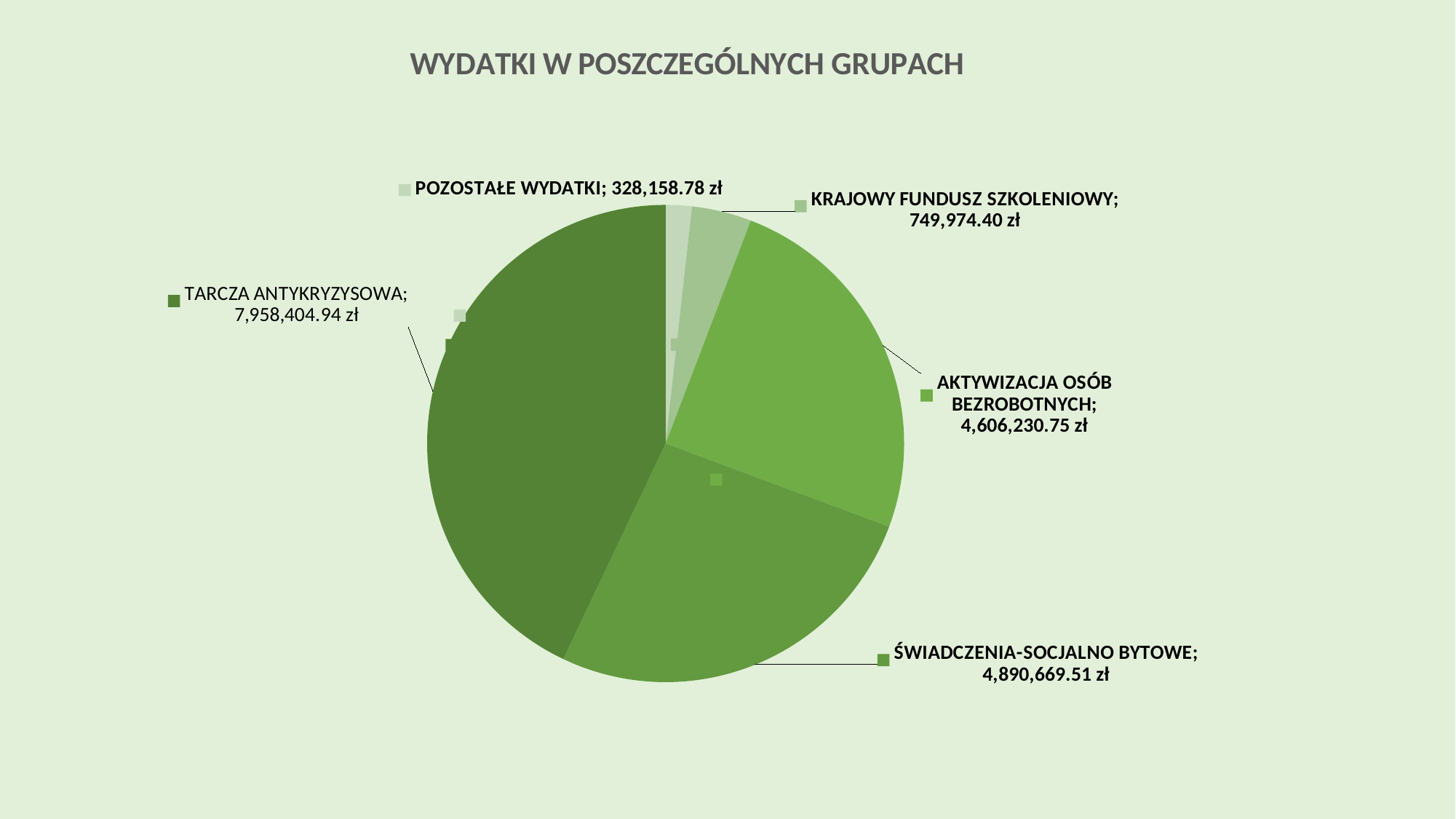
What is the title of the chart? WYDATKI W POSZCZEGÓLNYCH GRUPACH What is the difference between ŚWIADCZENIA-SOCJALNO BYTOWE and AKTYWIZACJA OSÓB BEZROBOTNYCH? 284,438.76 zł What is the value for TARCZA ANTYKRYZYSOWA? 7,958,404.94 zł What is the difference between KRAJOWY FUNDUSZ SZKOLENIOWY and POZOSTAŁE WYDATKI? 421,815.62 zł What is the value for KRAJOWY FUNDUSZ SZKOLENIOWY? 749,974.40 zł Which category has the smallest value? POZOSTAŁE WYDATKI What is the value for POZOSTAŁE WYDATKI? 328,158.78 zł Which is larger, ŚWIADCZENIA-SOCJALNO BYTOWE or AKTYWIZACJA OSÓB BEZROBOTNYCH? ŚWIADCZENIA-SOCJALNO BYTOWE How many slices does the pie chart have? 5 What type of chart is shown on the slide? pie chart What is the value for AKTYWIZACJA OSÓB BEZROBOTNYCH? 4,606,230.75 zł Which category has the largest value? TARCZA ANTYKRYZYSOWA